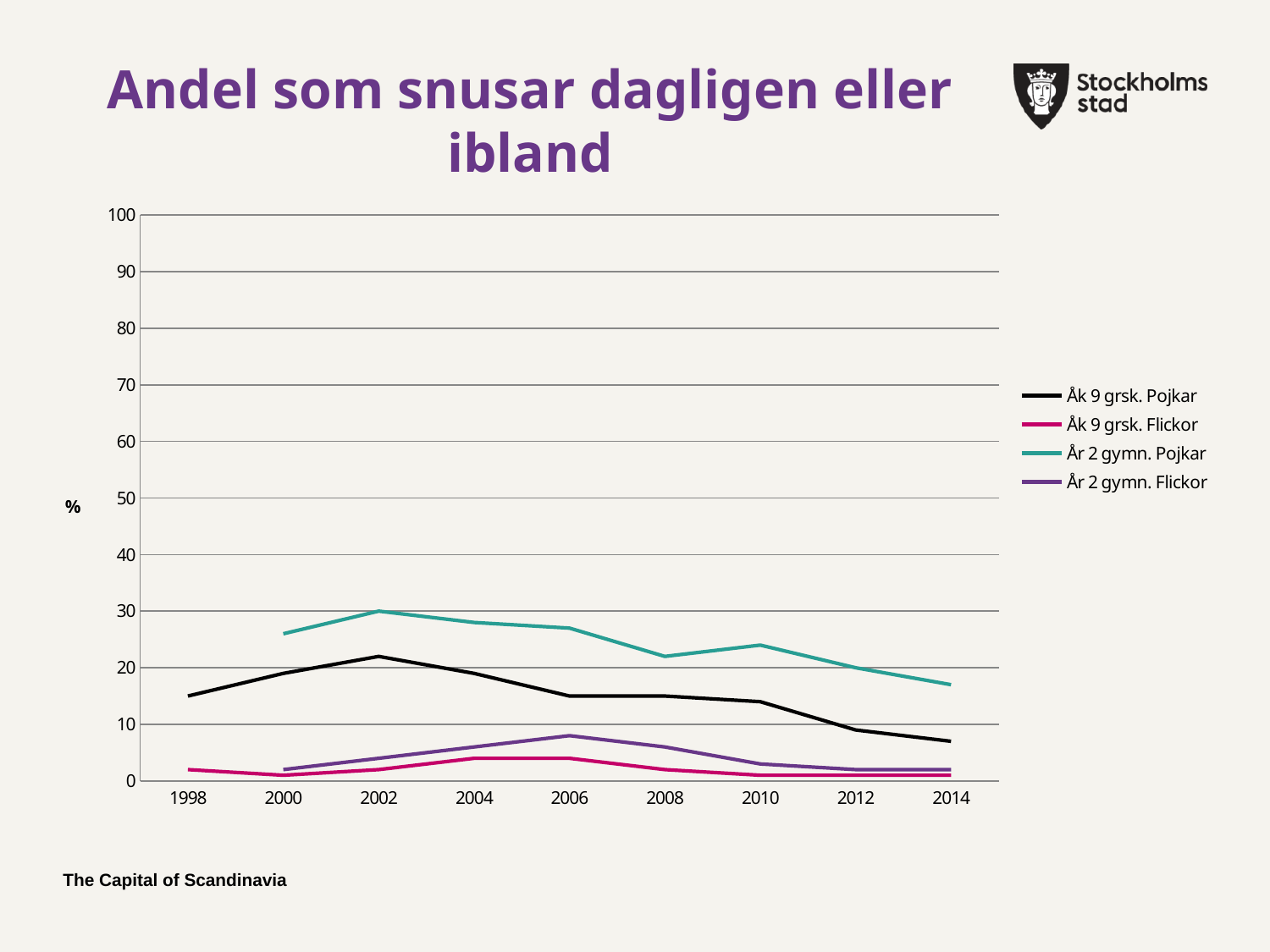
In which year does the Åk 9 grsk. Pojkar series reach its highest value? 2002 Does the Åk 9 grsk. Pojkar series rise or fall from 2002 to 2014? fall What is the label on the y axis? % How many years are labelled on the x axis? 9 In 2006, which is larger: the value for Åk 9 grsk. Pojkar or the value for År 2 gymn. Flickor? Åk 9 grsk. Pojkar Is the value for År 2 gymn. Pojkar in 2014 greater or less than 20? less What kind of chart is shown on the slide? line chart What is the title of the chart? Andel som snusar dagligen eller ibland Which series has the highest value in 2014? År 2 gymn. Pojkar Is the value for Åk 9 grsk. Pojkar in 1998 greater or less than 10? greater Is the value for Åk 9 grsk. Pojkar in 2002 greater or less than 20? greater How many series does the legend list? 4